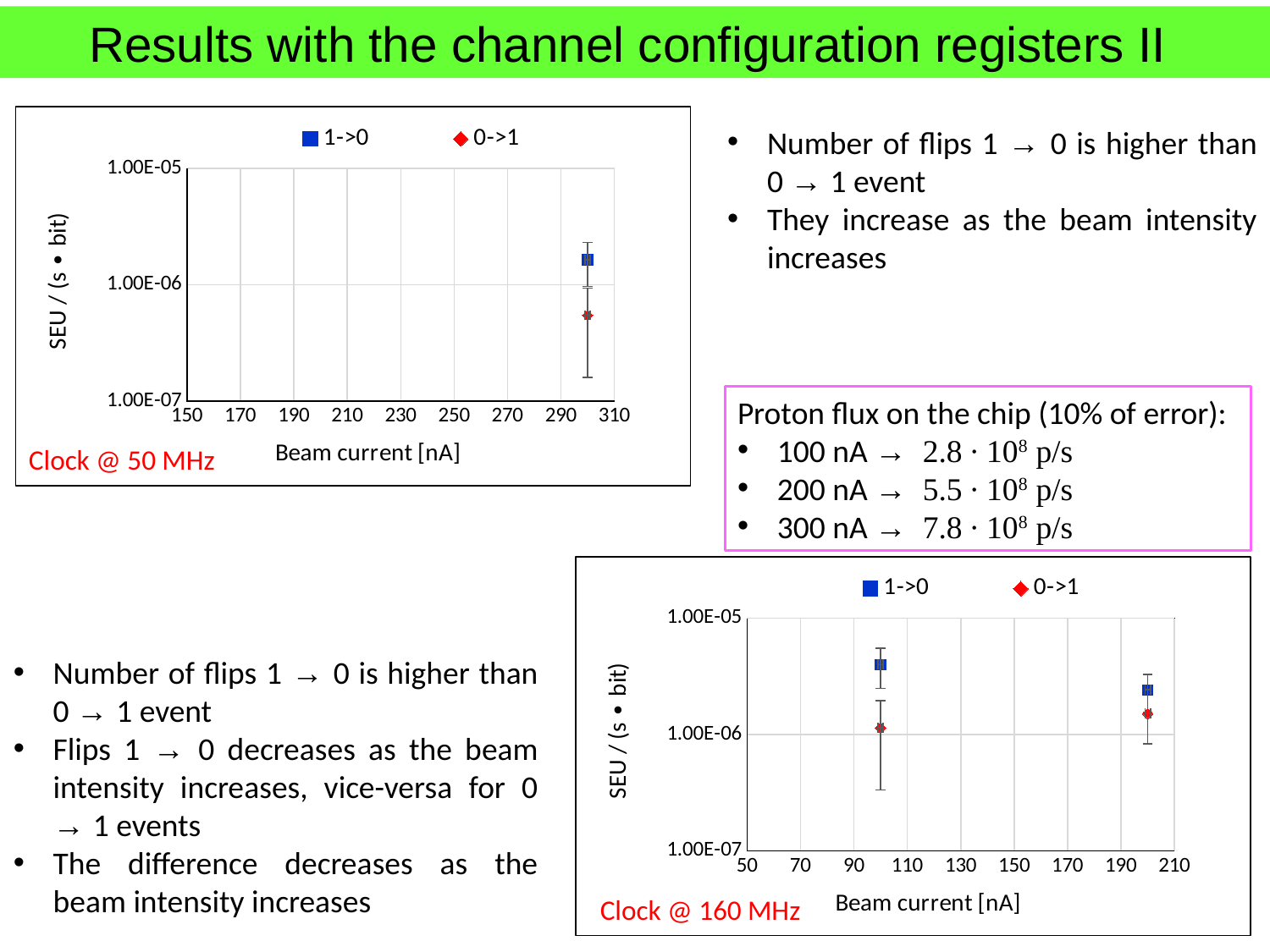
In the 'Clock @ 160 MHz' chart, at about 100 nA, which series has the higher SEU value, 1->0 or 0->1? 1->0 In the 'Clock @ 50 MHz' chart, is the value for the 0->1 series greater or less than 1.00E-06? less In the 'Clock @ 160 MHz' chart, does the 1->0 series rise or fall as beam current increases from about 100 nA to about 200 nA? fall In the 'Clock @ 160 MHz' chart, is the 1->0 value at about 200 nA greater or less than 1.00E-05? less How many series does the legend of the 'Clock @ 50 MHz' chart list? 2 What is the x-axis label of the 'Clock @ 160 MHz' chart? Beam current [nA] What are the two series named in the legend of the 'Clock @ 160 MHz' chart? 1->0 and 0->1 What kind of chart is the 'Clock @ 50 MHz' chart at the top left? scatter chart In the 'Clock @ 50 MHz' chart, which series has the higher SEU value, 1->0 or 0->1? 1->0 In the 'Clock @ 50 MHz' chart, is the value for the 1->0 series greater or less than 1.00E-06? greater How many beam current values have data points plotted in the 'Clock @ 160 MHz' chart? 2